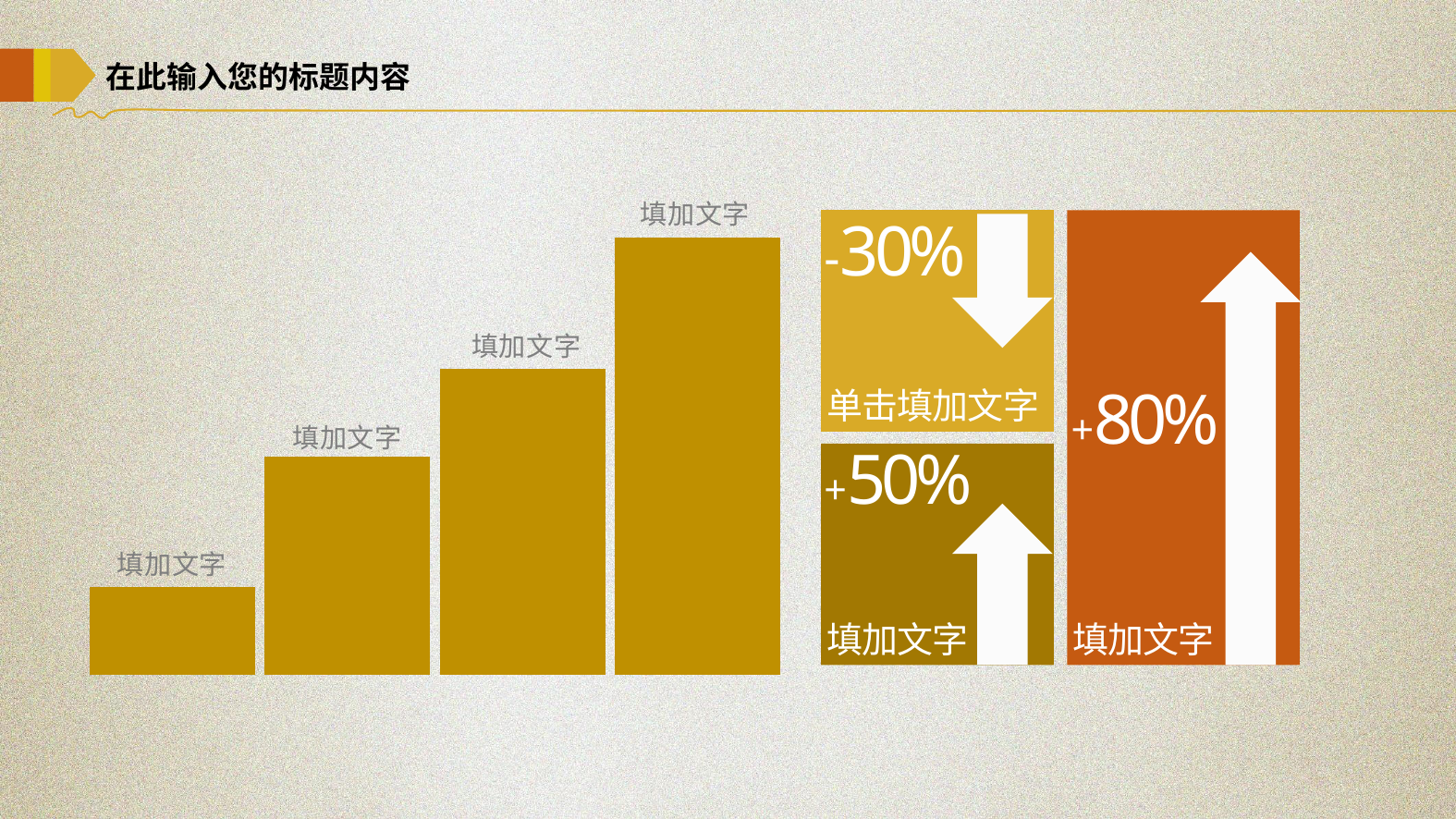
What kind of chart is shown on the left of the slide? bar chart What colour are the bars in the chart on the left of the slide? golden yellow Which bar in the chart on the left is the tallest? the fourth (rightmost) bar In the chart on the left, is the fourth bar taller or shorter than the first bar? taller In the chart on the left, is the second bar taller or shorter than the third bar? shorter Which bar in the chart on the left is the shortest? the first (leftmost) bar What label text appears above each bar in the chart on the left? 填加文字 How many bars does the bar chart on the left of the slide have? 4 Do the bars in the chart on the left rise or fall from left to right? rise